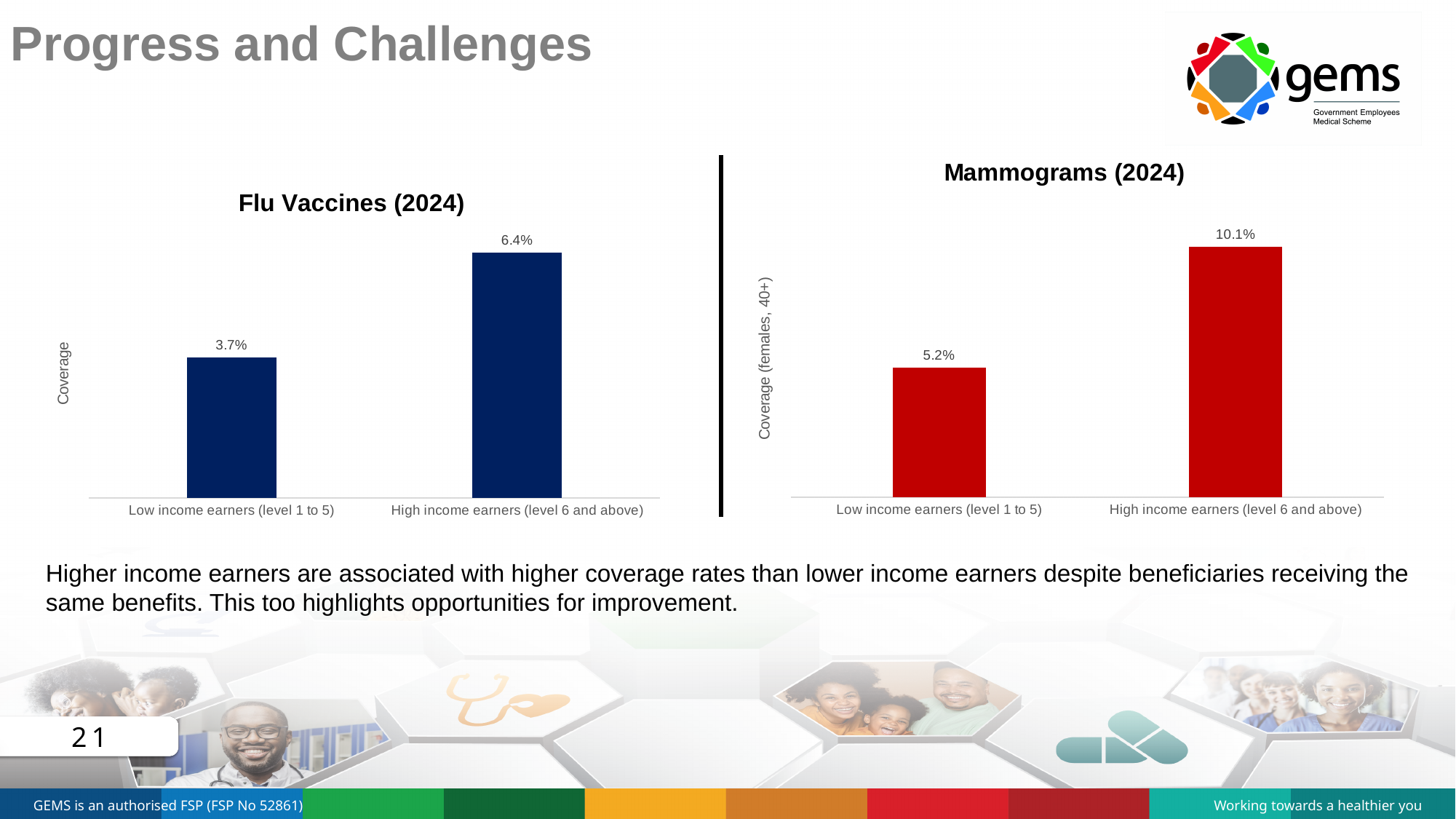
What is the y-axis label of the Mammograms (2024) chart? Coverage (females, 40+) In the Mammograms (2024) chart, which category has the lowest coverage? Low income earners (level 1 to 5) In the Mammograms (2024) chart, what is the difference in coverage between high income earners and low income earners? 4.9% Which is larger: the low income earners value in the Mammograms (2024) chart or the high income earners value in the Flu Vaccines (2024) chart? High income earners in the Flu Vaccines (2024) chart In the Flu Vaccines (2024) chart, what is the coverage for high income earners (level 6 and above)? 6.4% What kind of chart is the Flu Vaccines (2024) chart? Bar chart In the Flu Vaccines (2024) chart, what is the coverage for low income earners (level 1 to 5)? 3.7% How many categories are shown in the Mammograms (2024) chart? 2 In the Flu Vaccines (2024) chart, which category has the highest coverage? High income earners (level 6 and above) In the Flu Vaccines (2024) chart, what is the difference in coverage between high income earners and low income earners? 2.7% In the Mammograms (2024) chart, what is the coverage for high income earners (level 6 and above)? 10.1% In the Mammograms (2024) chart, what is the coverage for low income earners (level 1 to 5)? 5.2%